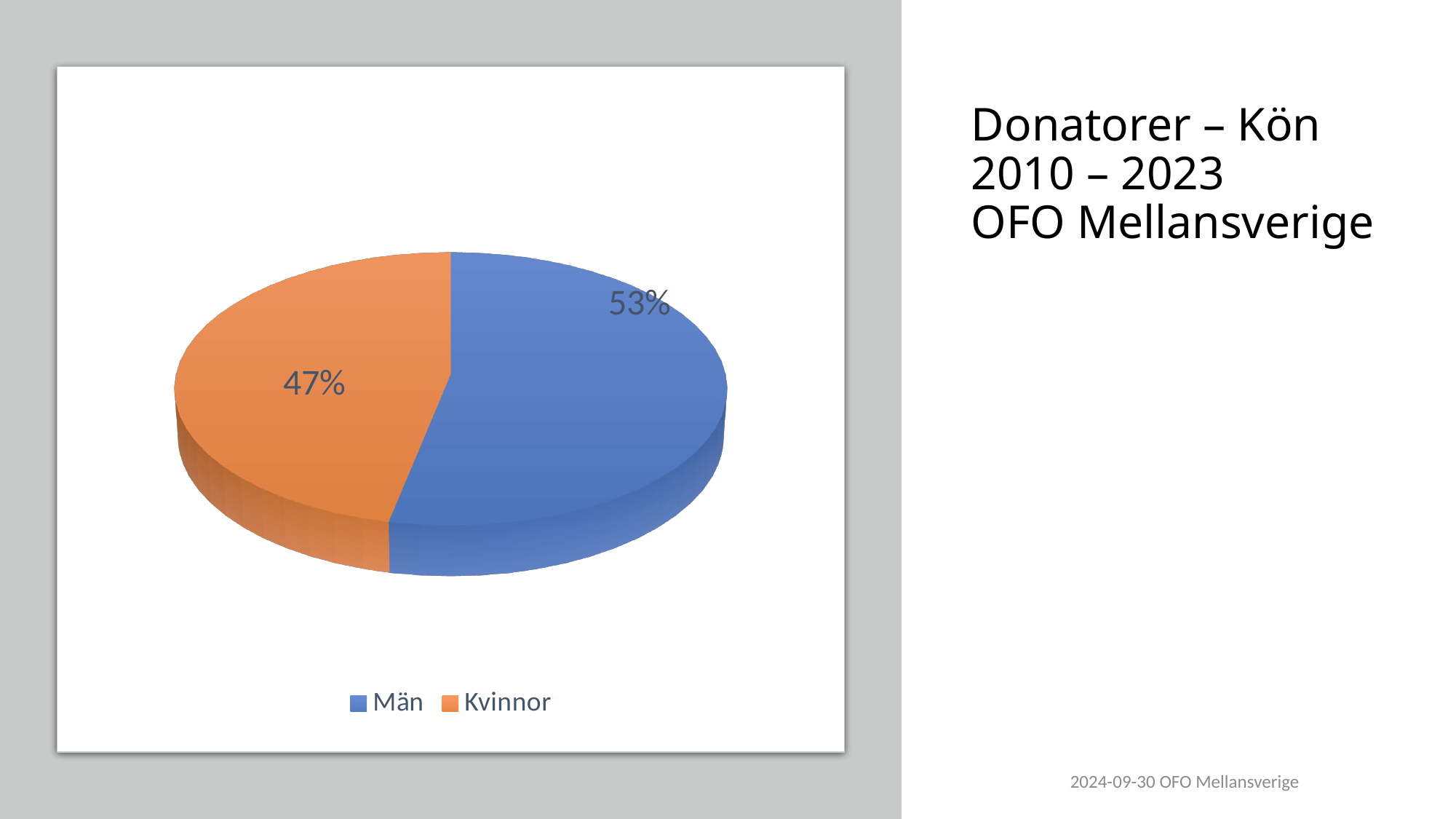
What kind of chart is shown on the slide? pie chart What share of the pie is labelled for Kvinnor? 47% What colour is the Kvinnor slice? orange Is the share for Män greater or less than 50%? greater What is the difference in percentage points between the Män and Kvinnor slices? 6 How many entries does the legend list? 2 Which category has the largest slice of the pie? Män Which category has the smallest slice of the pie? Kvinnor Which slice is larger, Män or Kvinnor? Män What colour is the Män slice? blue How many slices does the pie chart have? 2 What share of the pie is labelled for Män? 53%